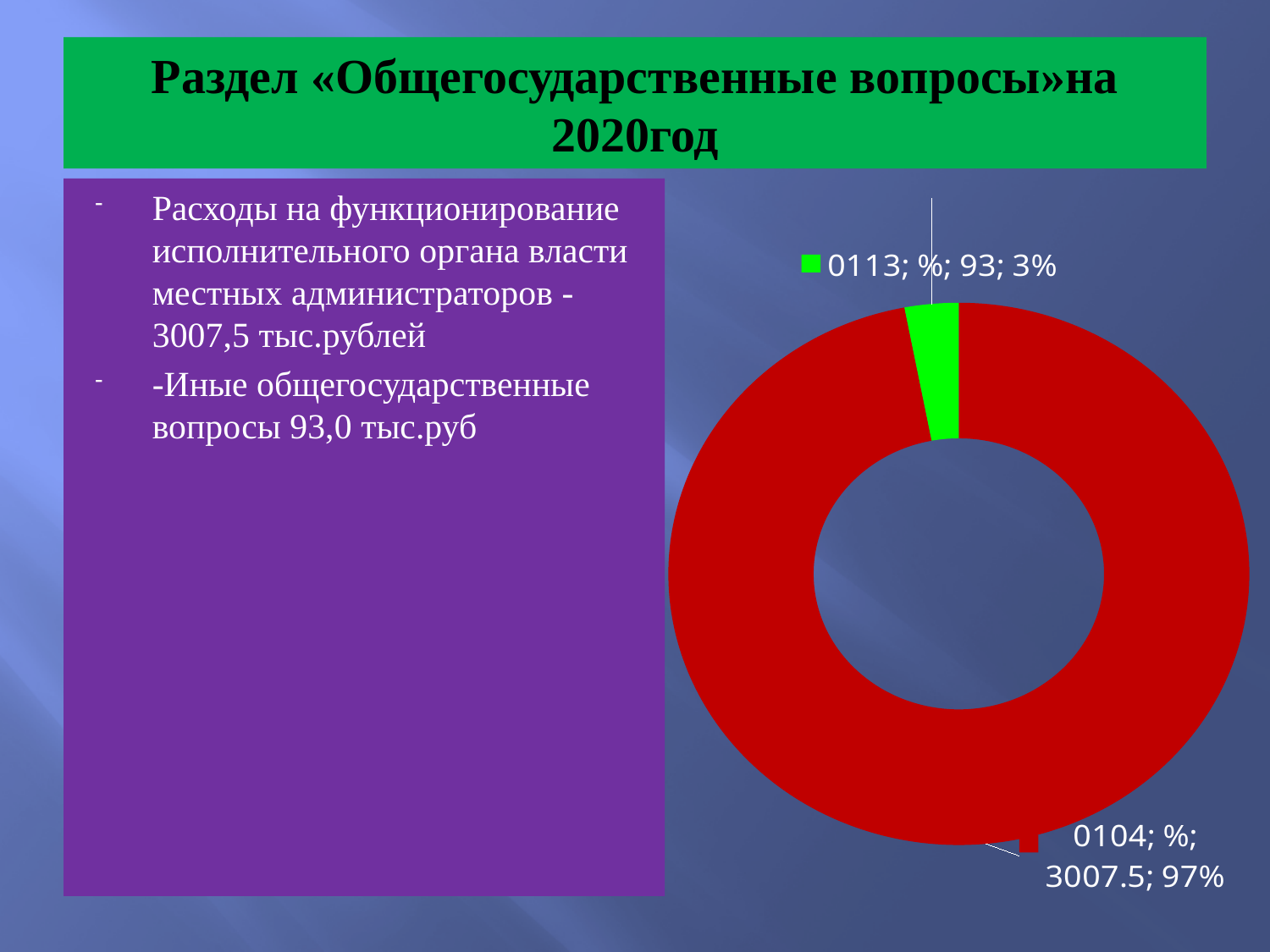
What share of the doughnut does category 0113 take? 3% What kind of chart is shown on the slide? doughnut chart Which category has the smallest slice? 0113 Which category has the largest slice? 0104 What value is shown for category 0104? 3007.5 What colour is the slice for category 0104? red What is the difference between the values for 0104 and 0113? 2914.5 What share of the doughnut does category 0104 take? 97% Which is larger, the value for 0104 or the value for 0113? 0104 How many slices does the doughnut chart have? 2 What colour is the slice for category 0113? green What value is shown for category 0113? 93